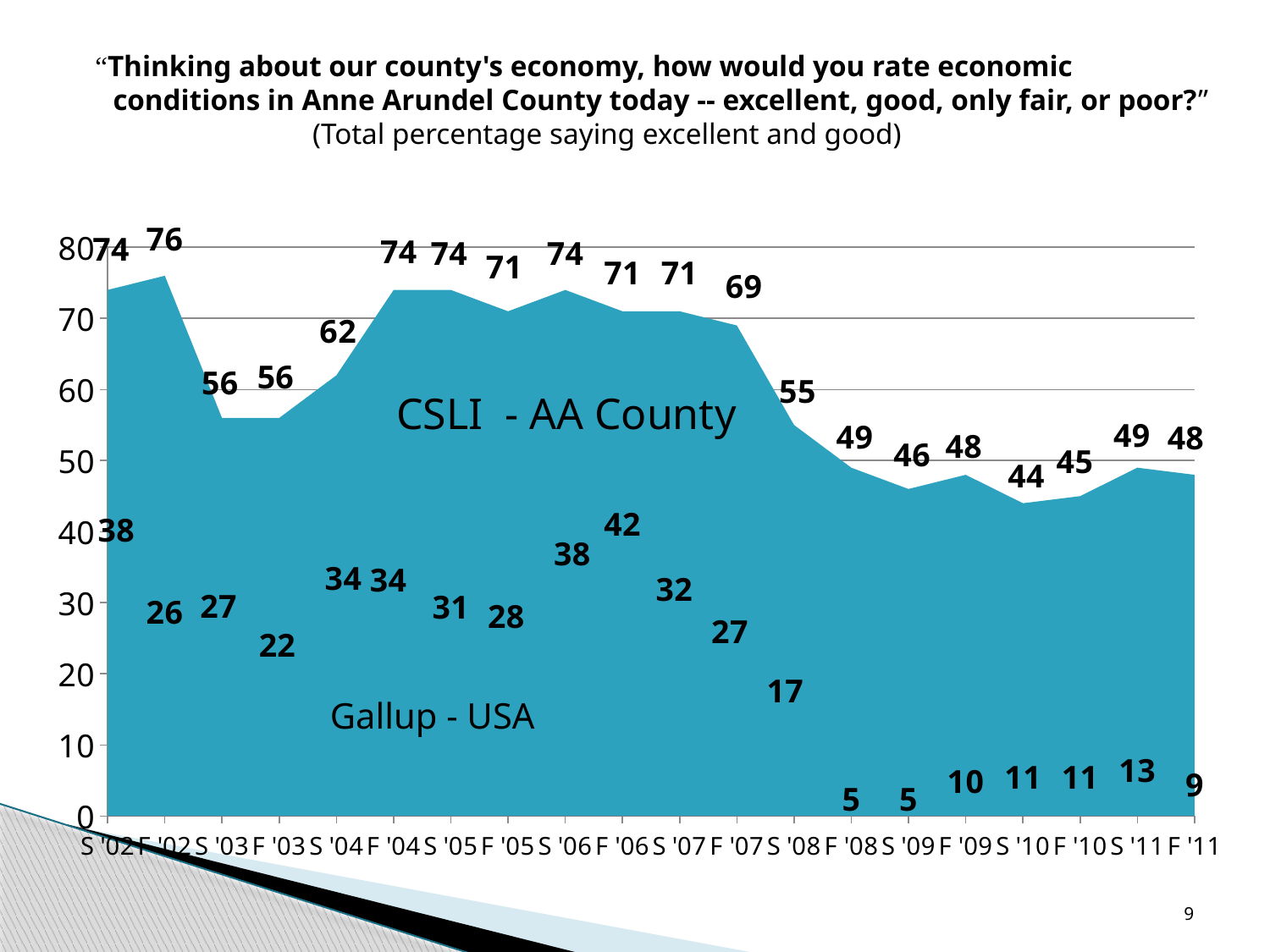
Which is larger, the Gallup - USA value for S '06 or for F '07? S '06 How many time periods are shown on the x axis? 20 What kind of chart is shown on the slide? Area chart What is the difference between the CSLI - AA County value and the Gallup - USA value for S '02? 36 What is the CSLI - AA County value for F '11? 48 What is the CSLI - AA County value for F '02? 76 Which period has the highest CSLI - AA County value? F '02 Which period has the lowest CSLI - AA County value? S '10 What is the Gallup - USA value for F '06? 42 What are the names of the two series shown on the chart? CSLI - AA County and Gallup - USA Do the CSLI - AA County values rise or fall from F '07 to S '10? Fall What is the Gallup - USA value for S '08? 17